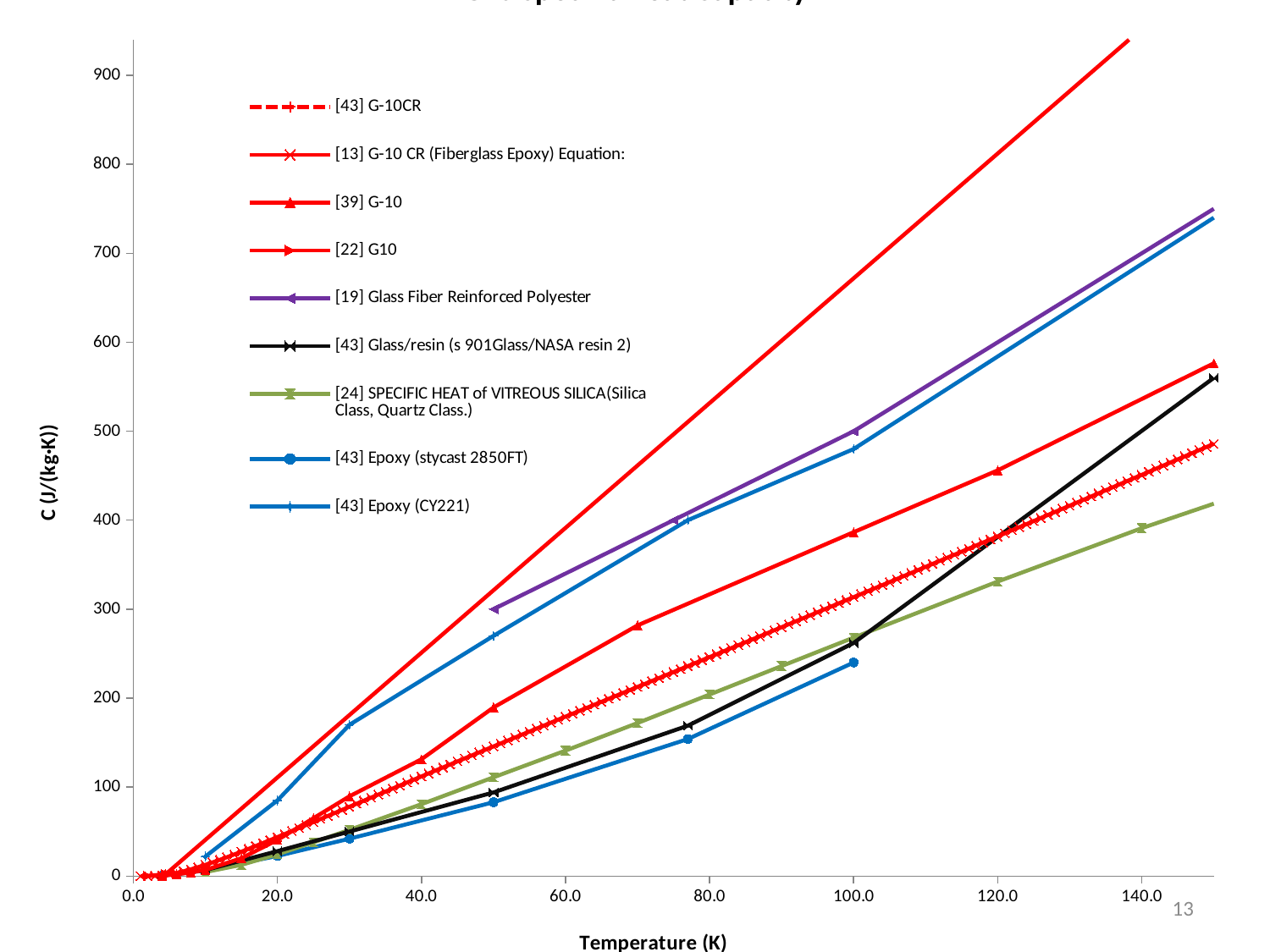
At 150 K, which is higher: [39] G-10 or [24] SPECIFIC HEAT of VITREOUS SILICA? [39] G-10 Do the values of the series rise or fall as temperature increases along the x axis? rise Which series has the lowest value at 100 K? [43] Epoxy (stycast 2850FT) Is the value for [43] Glass/resin (s 901Glass/NASA resin 2) at 150 K greater or less than 500? greater Is the value for [39] G-10 at 150 K greater or less than 500? greater At 100 K, which is higher: [19] Glass Fiber Reinforced Polyester or [22] G10? [22] G10 How many series does the legend list? 9 What is the title of the x axis? Temperature (K) What kind of chart is shown on the slide? line chart Is the value for [43] Epoxy (CY221) at 50 K greater or less than 300? less What is the title of the y axis? C (J/(kg·K))